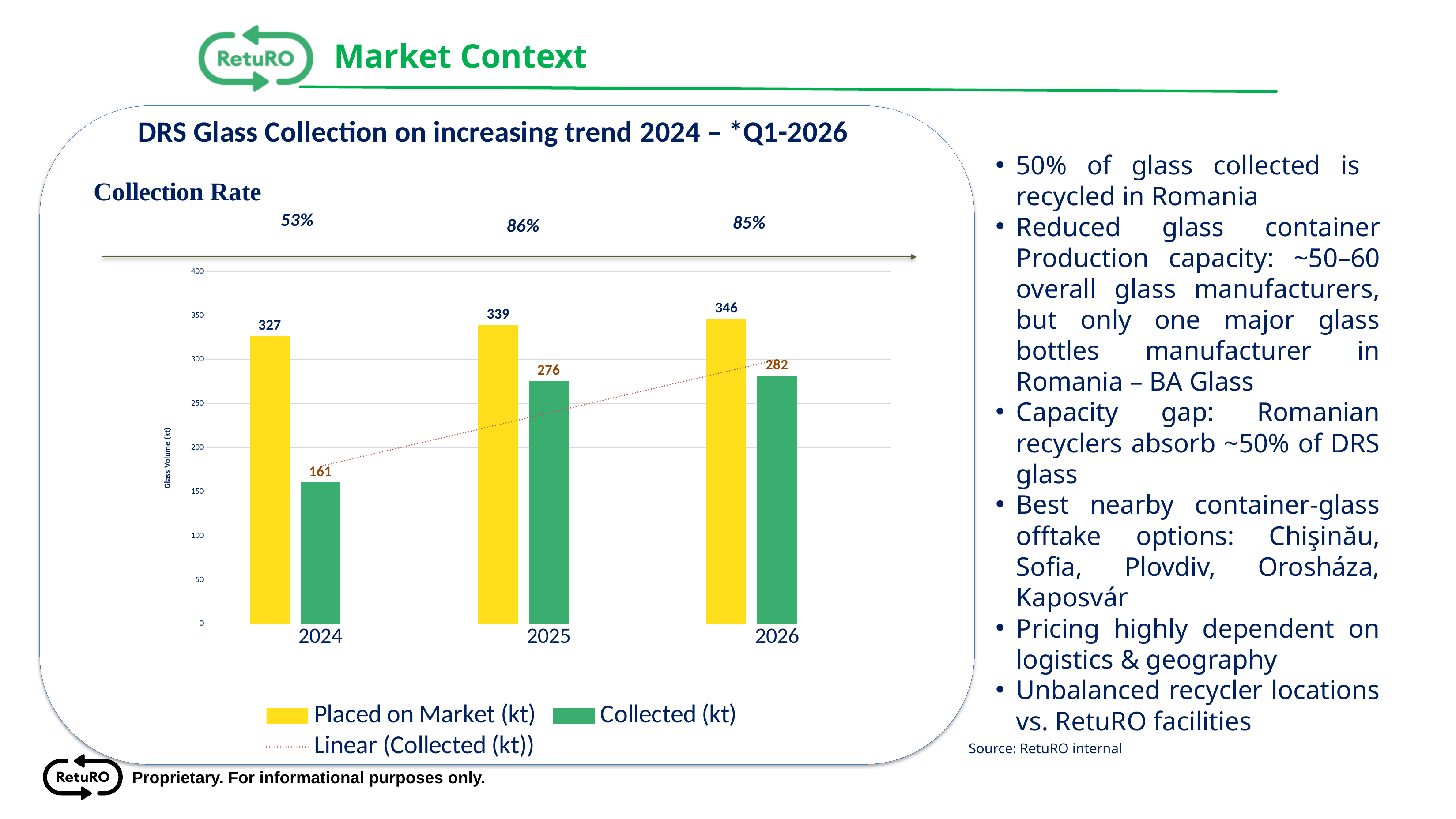
Which year has the lowest Collected (kt) value? 2024 Which is larger in 2025: Placed on Market (kt) or Collected (kt)? Placed on Market (kt) Which year has the highest Placed on Market (kt) value? 2026 What is the value of Collected (kt) for 2025? 276 What is the value of Collected (kt) for 2026? 282 What kind of chart is used to show the glass volumes? Bar chart What collection rate is shown above the chart for 2025? 86% What is the difference between Placed on Market (kt) and Collected (kt) in 2024? 166 Do the Collected (kt) values rise or fall from 2024 to 2026? Rise How many entries does the chart legend list? 3 How many years are shown on the x axis of the chart? 3 What is the value of Placed on Market (kt) for 2024? 327